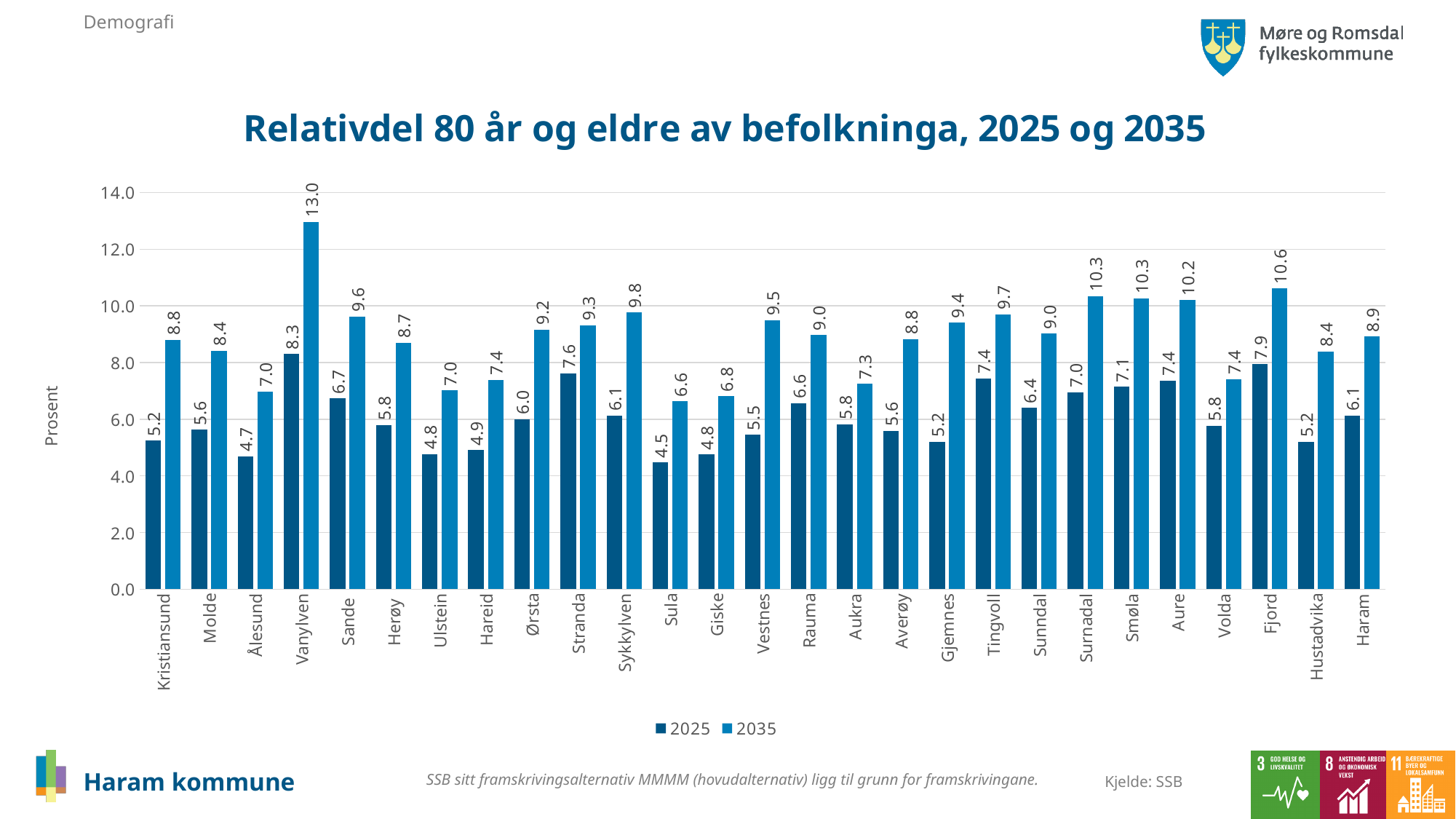
What is the title of the chart? Relativdel 80 år og eldre av befolkninga, 2025 og 2035 How many series does the legend list? 2 Which municipality has the highest value for 2035? Vanylven What is the value for Haram in 2035? 8.9 What kind of chart is shown on the slide? bar chart Is the 2035 value for Vanylven greater or less than 12.0? greater How many municipalities are shown on the x axis? 27 What is the label on the y axis? Prosent What is the difference between the 2035 and 2025 values for Haram? 2.8 What is the value for Vanylven in 2025? 8.3 Which municipality has the lowest value for 2025? Sula Which is larger, the 2035 value for Fjord or the 2035 value for Surnadal? Fjord